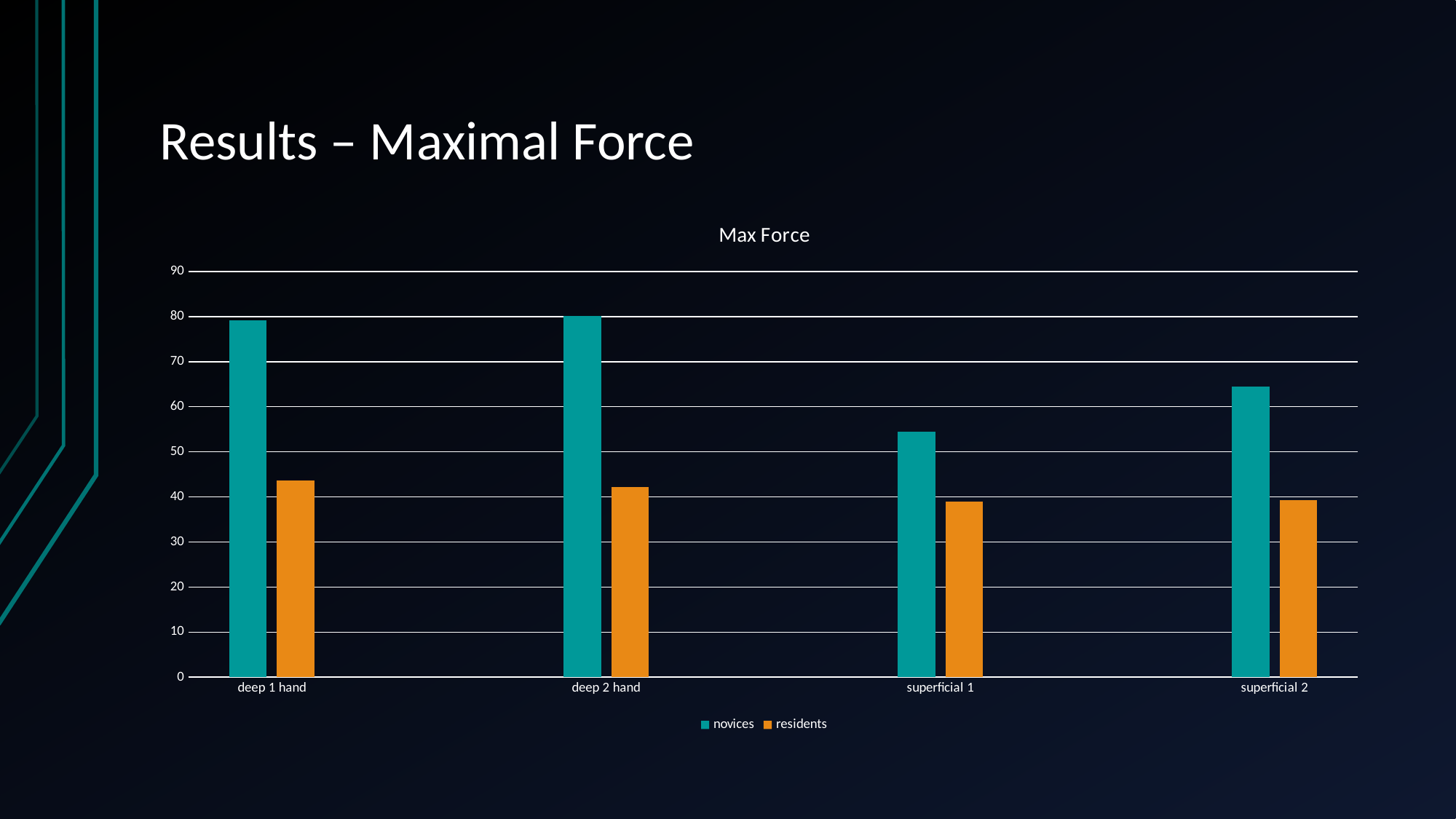
Is the value for residents at deep 1 hand greater or less than 50? less What is the title of the chart? Max Force Is the value for novices at deep 1 hand greater or less than 70? greater Which category has the lowest value for novices? superficial 1 At superficial 2, which is larger: the value for novices or the value for residents? novices Is the value for novices at superficial 2 greater or less than 60? greater How many categories are shown on the x axis? 4 How many series does the legend list? 2 What kind of chart is shown on the slide? bar chart Which series is shown in orange? residents For novices, which is larger: the value at superficial 1 or the value at superficial 2? superficial 2